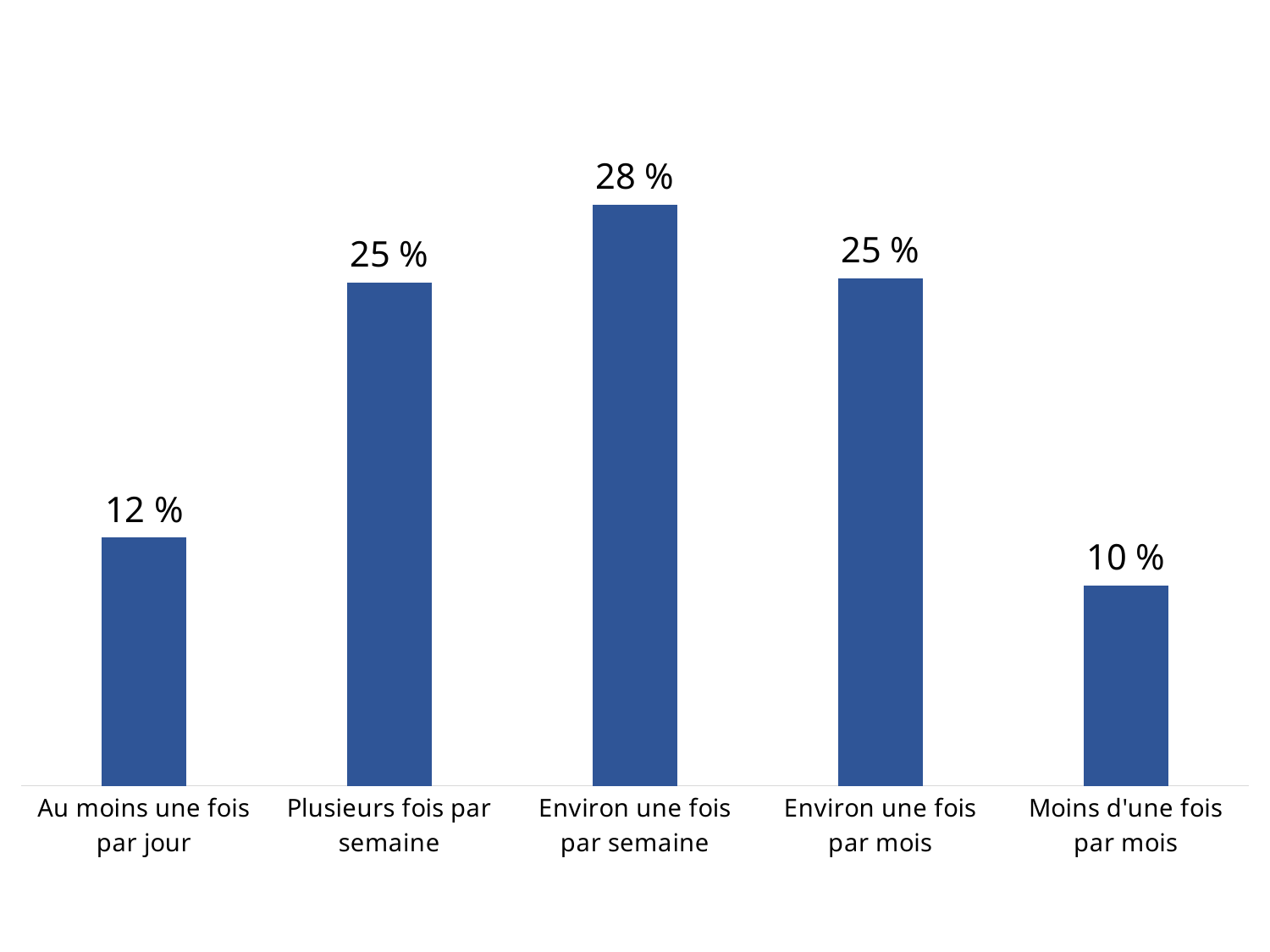
How many categories are shown on the chart? 5 What is the difference between the values for "Au moins une fois par jour" and "Moins d'une fois par mois"? 2 % What is the value for "Plusieurs fois par semaine"? 25 % What is the difference between the values for "Environ une fois par semaine" and "Au moins une fois par jour"? 16 % What is the value for "Environ une fois par semaine"? 28 % Which category has the lowest value? Moins d'une fois par mois Which category has the highest value? Environ une fois par semaine What kind of chart is shown on the slide? Bar chart What colour are the bars in the chart? Blue Which is larger, the value for "Environ une fois par semaine" or the value for "Environ une fois par mois"? Environ une fois par semaine What is the value for "Moins d'une fois par mois"? 10 % What is the value for "Au moins une fois par jour"? 12 %